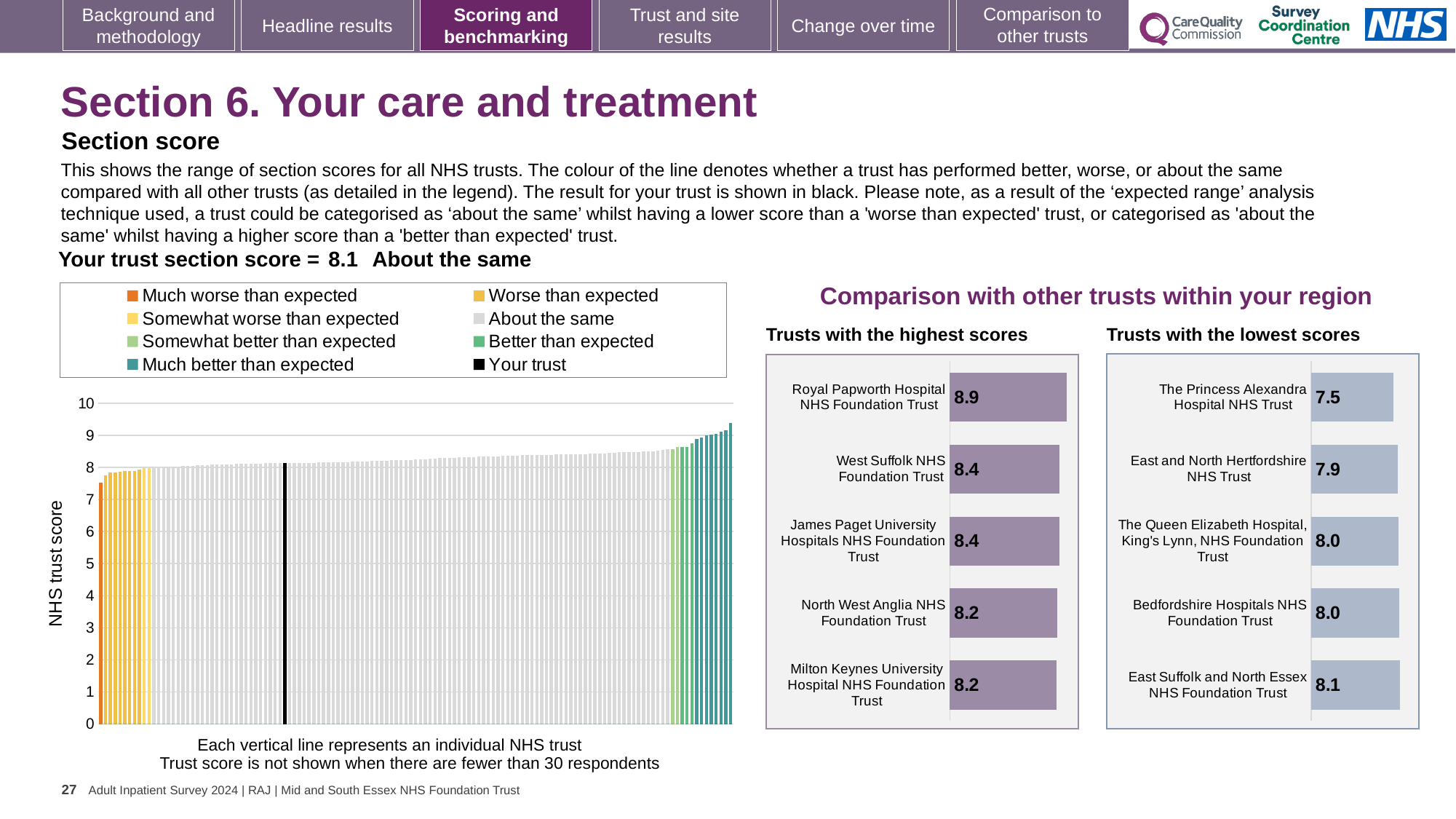
In the 'Trusts with the highest scores' chart, what is the score for Royal Papworth Hospital NHS Foundation Trust? 8.9 How many entries does the legend of the main 'NHS trust score' chart list? 8 According to the slide, what is your trust's section score shown in black on the main chart? 8.1 In the 'Trusts with the highest scores' chart, which trust has the highest score? Royal Papworth Hospital NHS Foundation Trust Which has the larger score: North West Anglia NHS Foundation Trust in the 'highest scores' chart or Bedfordshire Hospitals NHS Foundation Trust in the 'lowest scores' chart? North West Anglia NHS Foundation Trust In the 'Trusts with the lowest scores' chart, which trust has the lowest score? The Princess Alexandra Hospital NHS Trust How many trusts are shown in the 'Trusts with the highest scores' chart? 5 In the 'Trusts with the lowest scores' chart, what is the score for The Princess Alexandra Hospital NHS Trust? 7.5 In the main 'NHS trust score' chart, do the values rise or fall from left to right along the x axis? Rise In the 'Trusts with the lowest scores' chart, how much higher is the score of East Suffolk and North Essex NHS Foundation Trust than that of The Princess Alexandra Hospital NHS Trust? 0.6 What kind of chart is the main chart showing the NHS trust scores for all trusts? Bar chart In the 'Trusts with the highest scores' chart, what is the difference between the scores of Royal Papworth Hospital NHS Foundation Trust and West Suffolk NHS Foundation Trust? 0.5